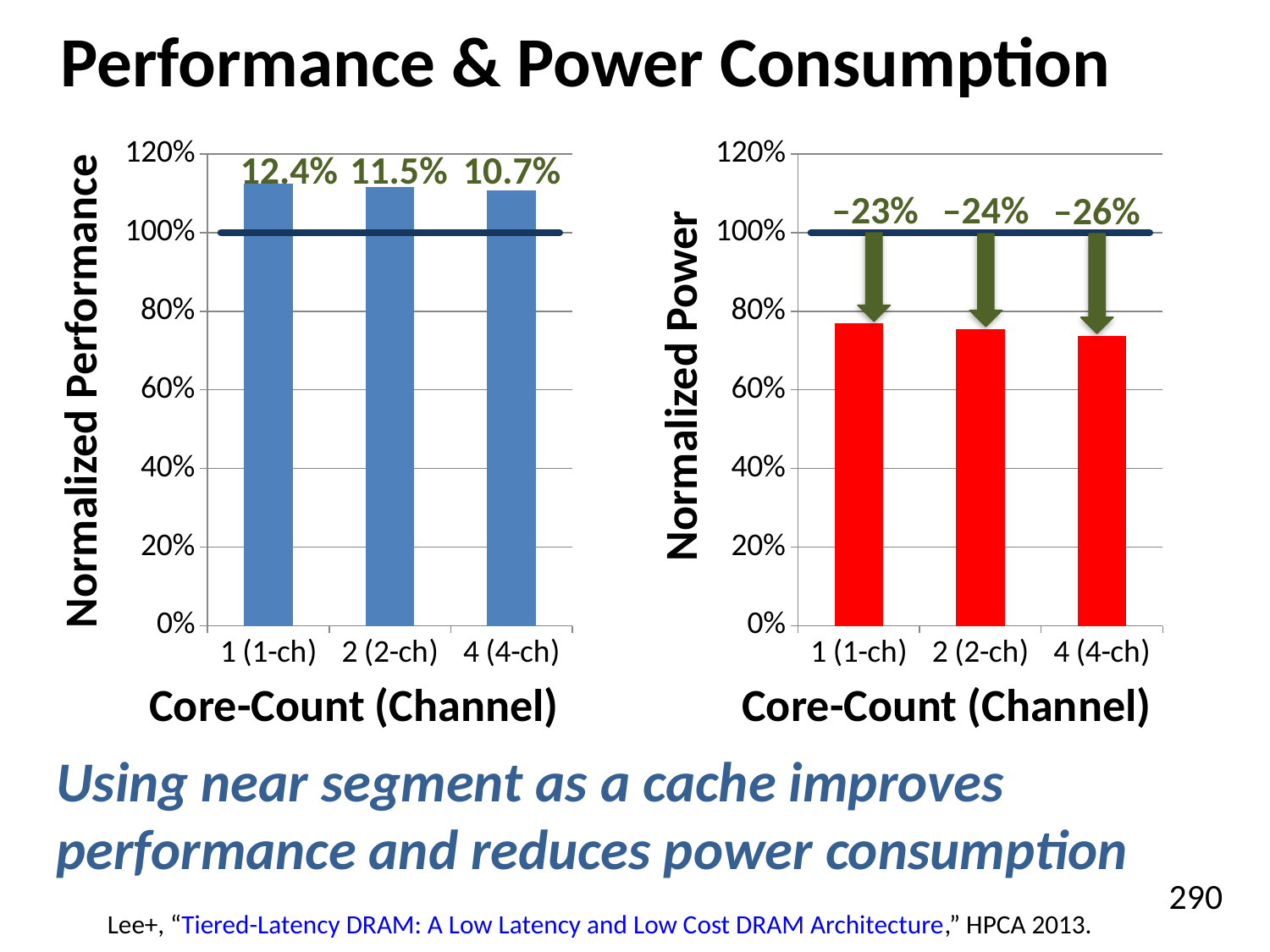
In the Normalized Performance chart on the left, what improvement label is shown above the bar for 4 (4-ch)? 10.7% In the Normalized Power chart on the right, which core-count category has the lowest bar? 4 (4-ch) In the Normalized Power chart on the right, what reduction label is shown above the bar for 4 (4-ch)? –26% In the Normalized Power chart on the right, what reduction label is shown above the bar for 2 (2-ch)? –24% How many core-count categories are plotted in the Normalized Power chart on the right? 3 In the Normalized Performance chart on the left, which core-count category has the highest bar? 1 (1-ch) In the Normalized Performance chart on the left, do the bar values rise or fall as the core count increases from 1 to 4? fall In the Normalized Performance chart on the left, is the value for 2 (2-ch) greater or less than 100%? greater What kind of chart is the Normalized Performance chart on the left? bar chart In the Normalized Performance chart on the left, what improvement label is shown above the bar for 1 (1-ch)? 12.4% What is the x-axis title of the Normalized Power chart on the right? Core-Count (Channel) In the Normalized Power chart on the right, is the value for 1 (1-ch) greater or less than 80%? less